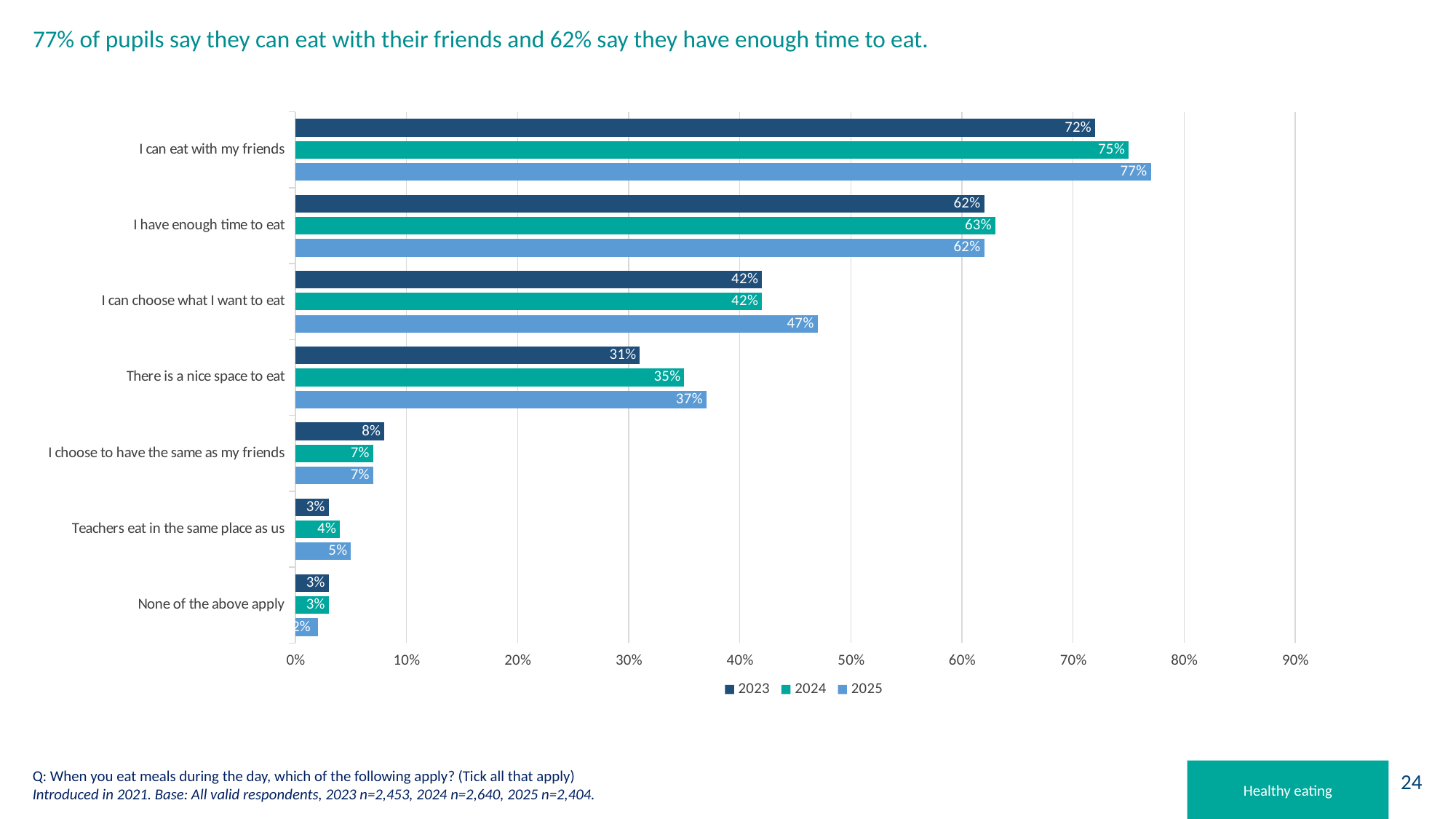
How many categories are shown on the chart? 7 What is the 2023 value for 'I can choose what I want to eat'? 42% What is the difference between the 2025 and 2024 values for 'I can choose what I want to eat'? 5 percentage points What is the 2024 value for 'There is a nice space to eat'? 35% Which category has the highest value in 2025? I can eat with my friends What kind of chart is shown on the slide? Bar chart What percentage of pupils said 'I can eat with my friends' in 2025? 77% Which category has the lowest value in 2025? None of the above apply Which is larger: the 2024 value for 'I have enough time to eat' or the 2025 value for 'I have enough time to eat'? 2024 What is the difference between the 2025 and 2023 values for 'I can eat with my friends'? 5 percentage points How many series does the legend list? 3 Which years are listed in the legend? 2023, 2024, 2025